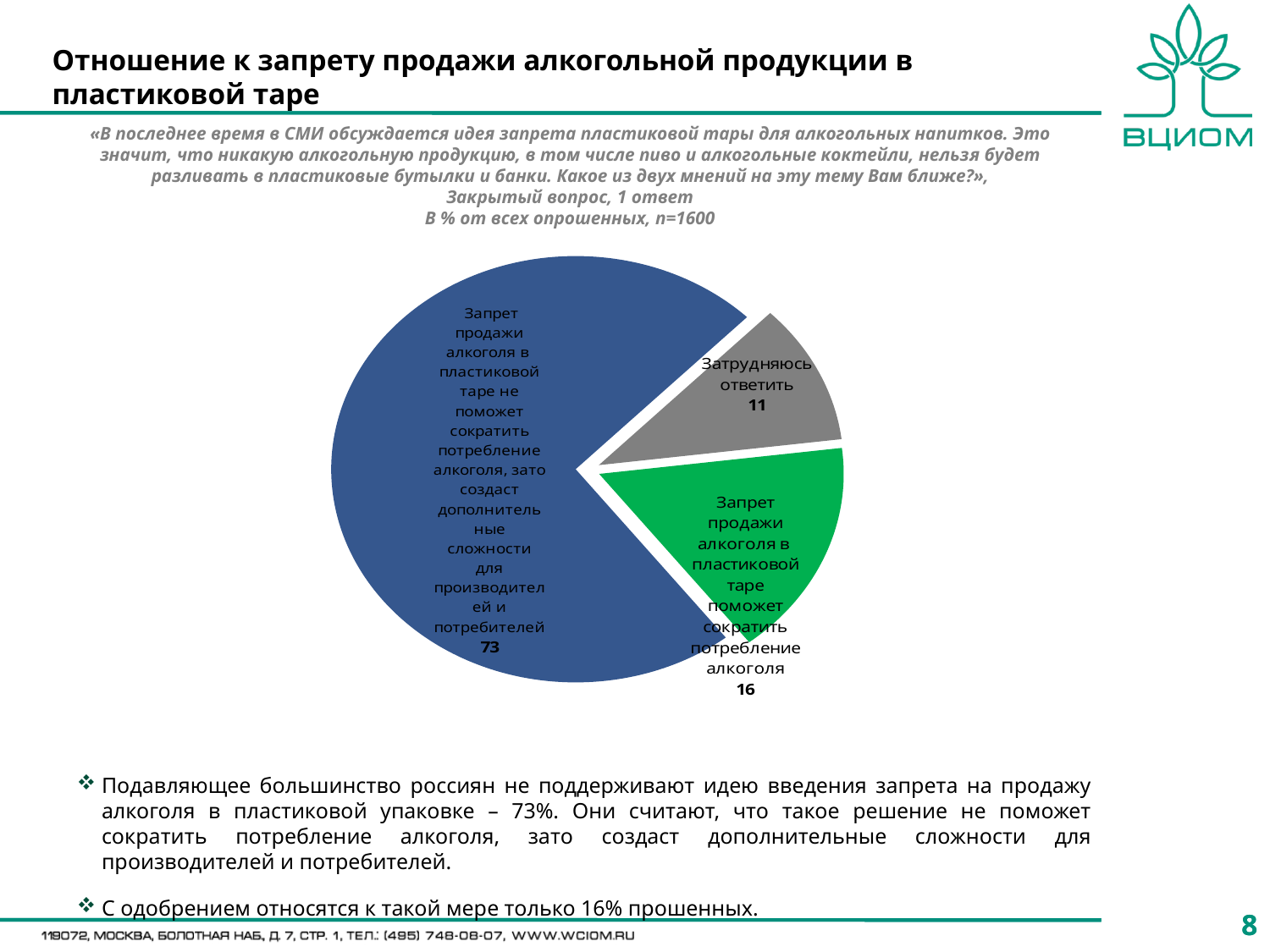
Какой тип диаграммы показан на слайде? круговая диаграмма Каким цветом показан сектор «Затрудняюсь ответить»? серым Какое значение у сектора «Запрет продажи алкоголя в пластиковой таре не поможет сократить потребление алкоголя, зато создаст дополнительные сложности для производителей и потребителей»? 73 Какое значение у сектора «Затрудняюсь ответить»? 11 Сколько секторов (категорий) на круговой диаграмме? 3 Что больше: значение сектора «поможет сократить потребление алкоголя» или сектора «Затрудняюсь ответить»? поможет сократить потребление алкоголя Каков объём выборки (n), указанный в подзаголовке диаграммы? n=1600 Какое значение у сектора «Запрет продажи алкоголя в пластиковой таре поможет сократить потребление алкоголя»? 16 Какой сектор диаграммы самый маленький? Затрудняюсь ответить На сколько значение сектора «поможет сократить потребление алкоголя» больше значения сектора «Затрудняюсь ответить»? 5 На сколько значение сектора «не поможет сократить потребление» больше значения сектора «поможет сократить потребление»? 57 Какой сектор диаграммы самый большой? Запрет продажи алкоголя в пластиковой таре не поможет сократить потребление алкоголя, зато создаст дополнительные сложности для производителей и потребителей